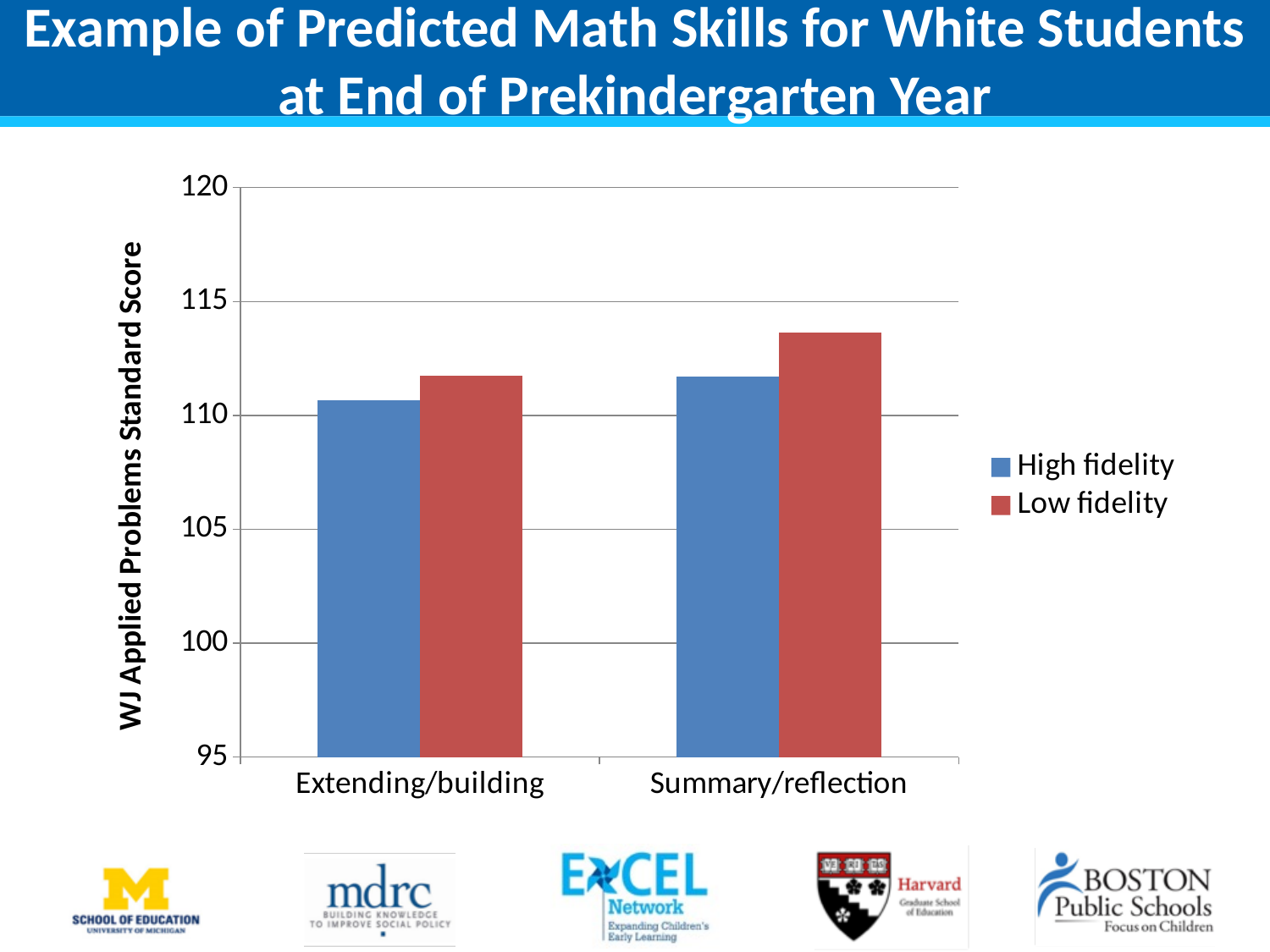
What are the two series named in the legend? High fidelity and Low fidelity Is the High fidelity value for Extending/building greater or less than 110? greater What kind of chart is shown on the slide? bar chart Which bar is the shortest on the chart? High fidelity for Extending/building How many categories are shown on the x axis? 2 What is the label of the y axis? WJ Applied Problems Standard Score For Extending/building, which series has the larger value, High fidelity or Low fidelity? Low fidelity Is the Low fidelity value for Extending/building greater or less than 115? less For Summary/reflection, which series has the larger value, High fidelity or Low fidelity? Low fidelity Which bar is the tallest on the chart? Low fidelity for Summary/reflection How many series does the legend list? 2 Is the Low fidelity value for Summary/reflection greater or less than 115? less